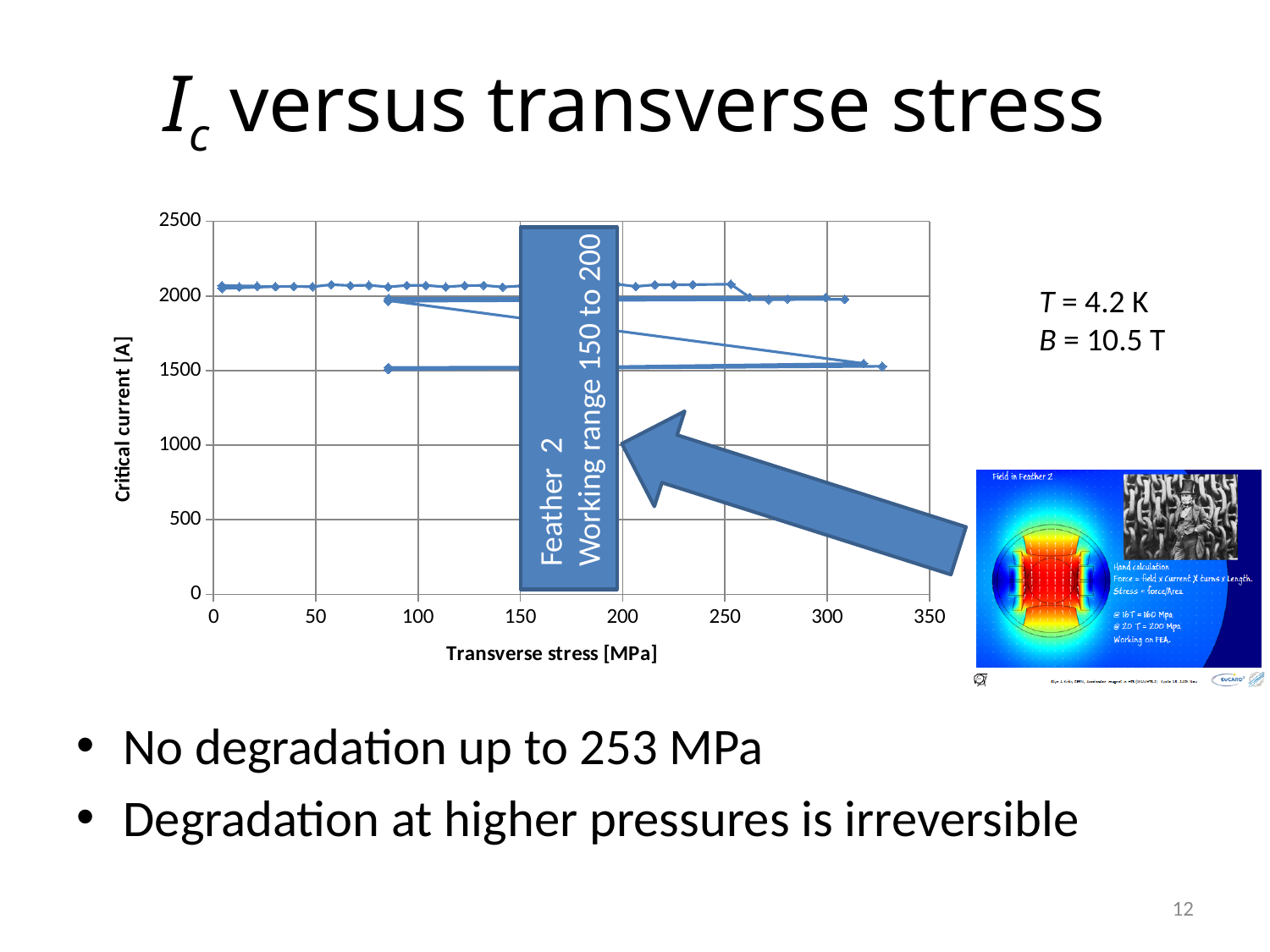
What kind of chart is shown on the slide? line chart What is the highest tick value shown on the x axis? 350 Is the critical current at 0 MPa transverse stress greater or less than 2500 A? less Is the lowest plotted critical current greater or less than 2000 A? less What is the label of the y axis of the chart? Critical current [A] Does the critical current rise or fall as the transverse stress increases beyond about 253 MPa? fall What is the label of the x axis of the chart? Transverse stress [MPa]